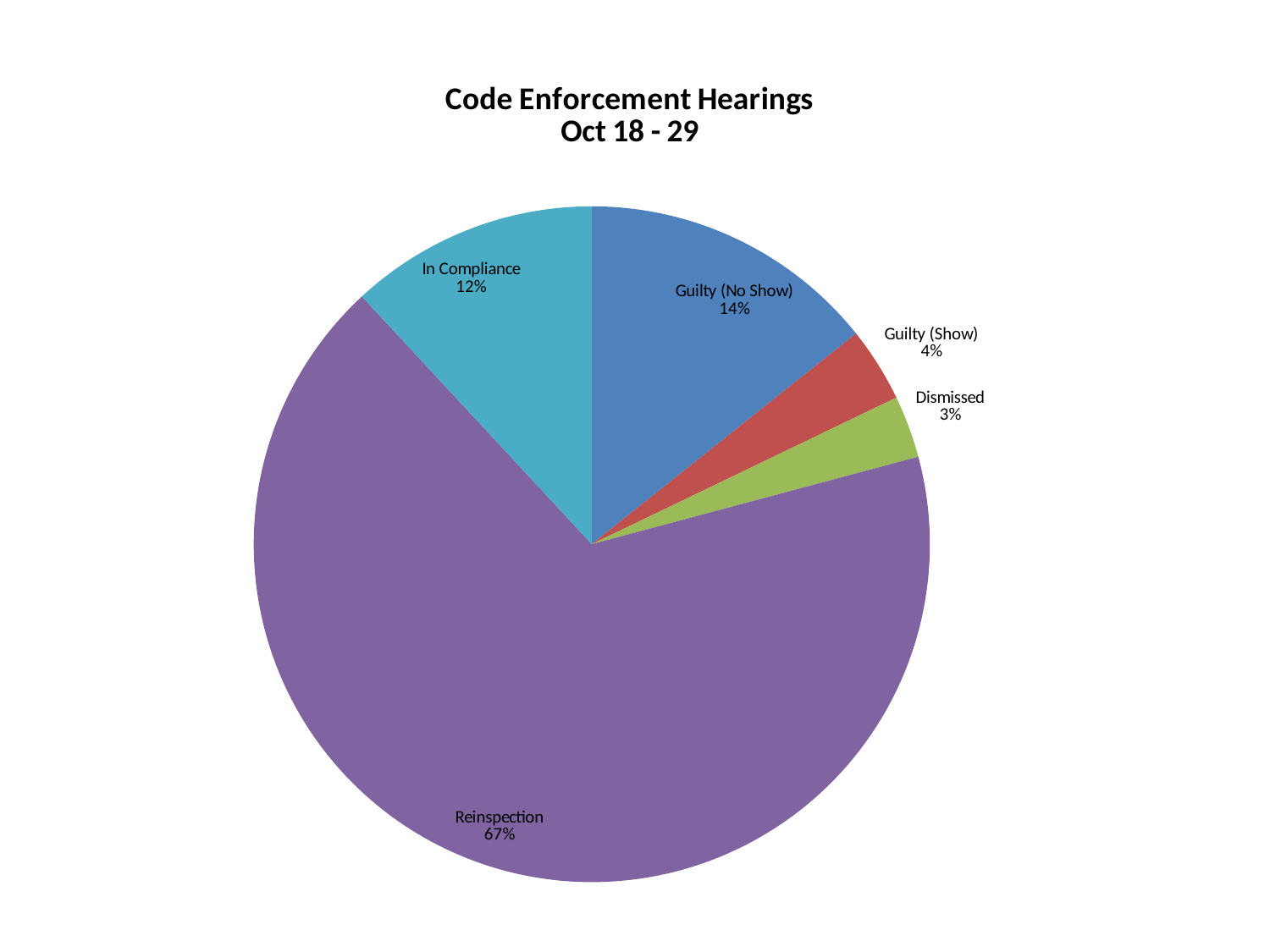
What share of the pie is Reinspection? 67% What kind of chart is shown on the slide? pie chart Which is larger, Guilty (No Show) or In Compliance? Guilty (No Show) What share of the pie is In Compliance? 12% Which category has the largest slice of the pie? Reinspection What is the title of the chart? Code Enforcement Hearings Oct 18 - 29 Which category has the smallest slice of the pie? Dismissed How many categories are shown in the pie chart? 5 What share of the pie is Dismissed? 3% What is the difference in percentage points between Reinspection and Guilty (No Show)? 53